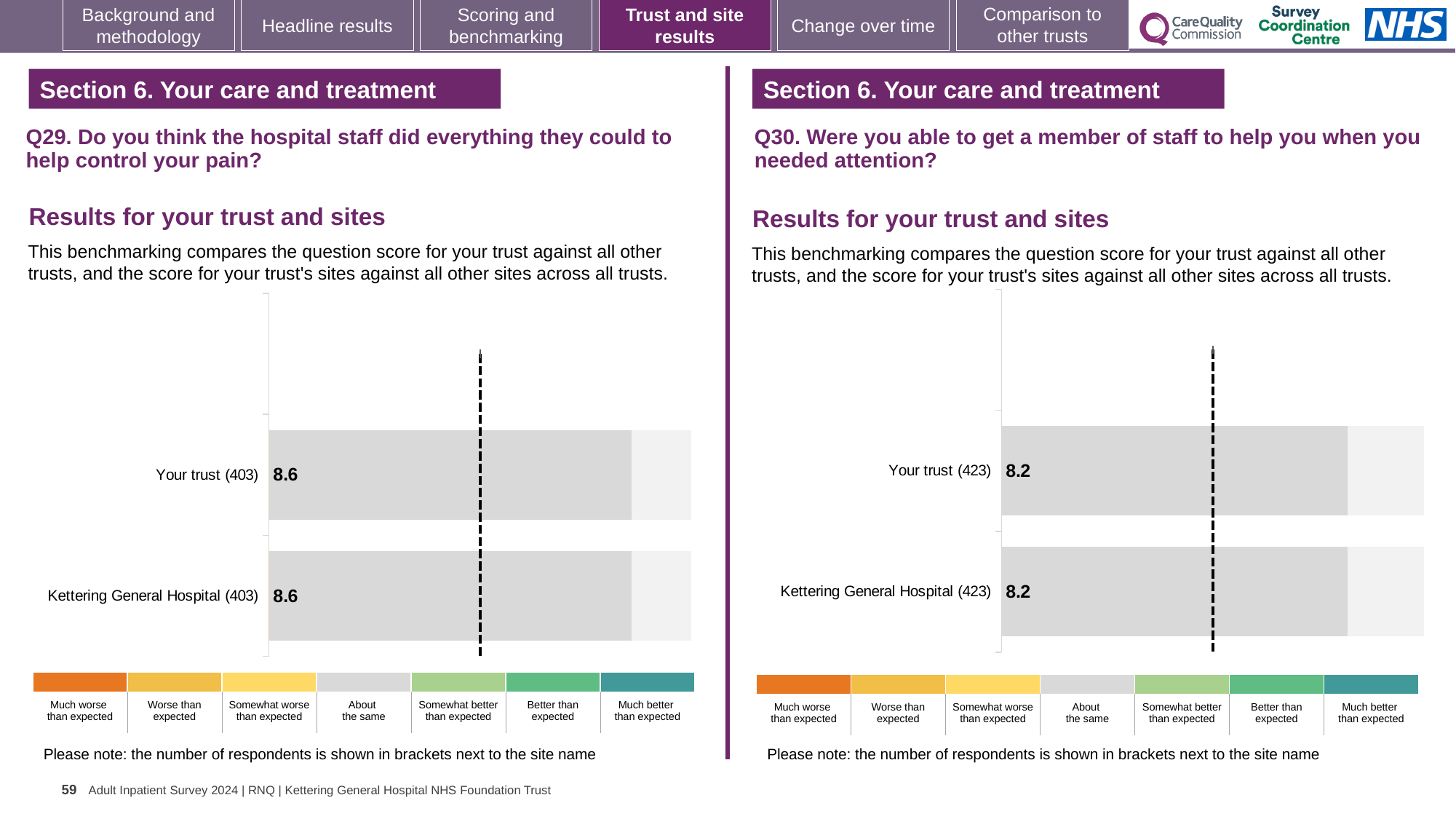
On the Q30 chart (right), how many bars are plotted? 2 On the Q29 chart (left), what is the score for Your trust? 8.6 On the Q29 chart (left), what is the difference between the score for Your trust and the score for Kettering General Hospital? 0.0 On the Q30 chart (right), what is the difference between the score for Your trust and the score for Kettering General Hospital? 0.0 On the Q30 chart (right), what is the score for Your trust? 8.2 On the Q29 chart (left), how many respondents are shown in brackets for Your trust? 403 On the Q29 chart (left), how many bars are plotted? 2 On the Q30 chart (right), what is the score for Kettering General Hospital? 8.2 On the Q29 chart (left), what is the score for Kettering General Hospital? 8.6 On the Q30 chart (right), how many respondents are shown in brackets for Kettering General Hospital? 423 On the Q30 chart (right), which benchmark category does the grey colour of the bars correspond to in the legend? About the same What kind of chart is used on the Q29 chart (left)? Bar chart